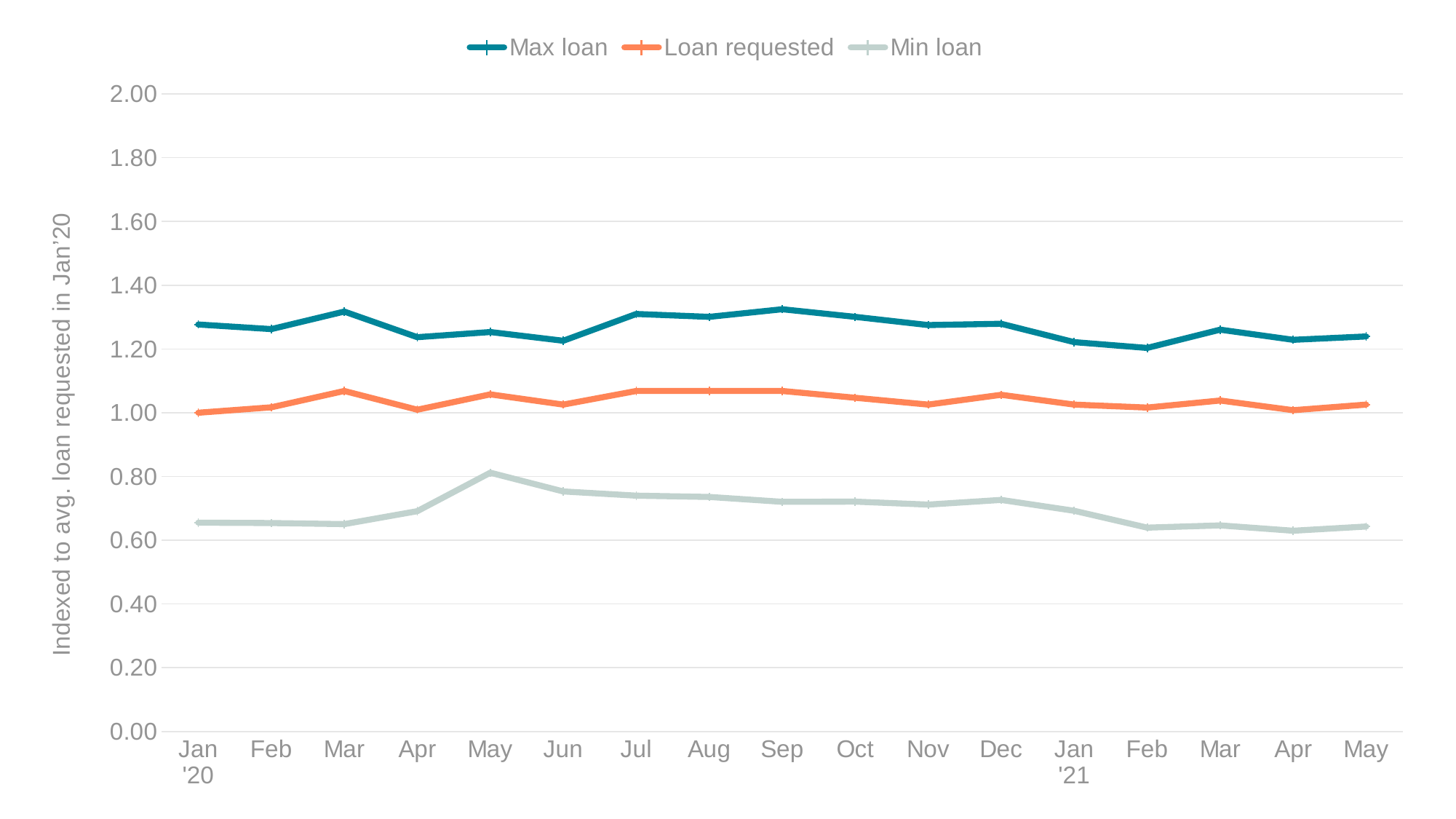
What is the title of the y axis? Indexed to avg. loan requested in Jan'20 What is the value of Loan requested in Jan '20? 1.00 Does the Min loan series rise or fall from May '20 to Feb '21? fall In which month does the Min loan series reach its highest value? May '20 What type of chart is shown on the slide? line chart How many months are plotted along the x axis? 17 What colour is the Loan requested line? orange Is the value for Loan requested in Sep '20 greater or less than 1.00? greater Which is larger for Max loan: the value in Mar '20 or the value in Apr '20? Mar '20 Is the value for Max loan in Mar '20 greater or less than 1.20? greater Is the value for Min loan in Feb '21 greater or less than 0.80? less How many series does the legend list? 3